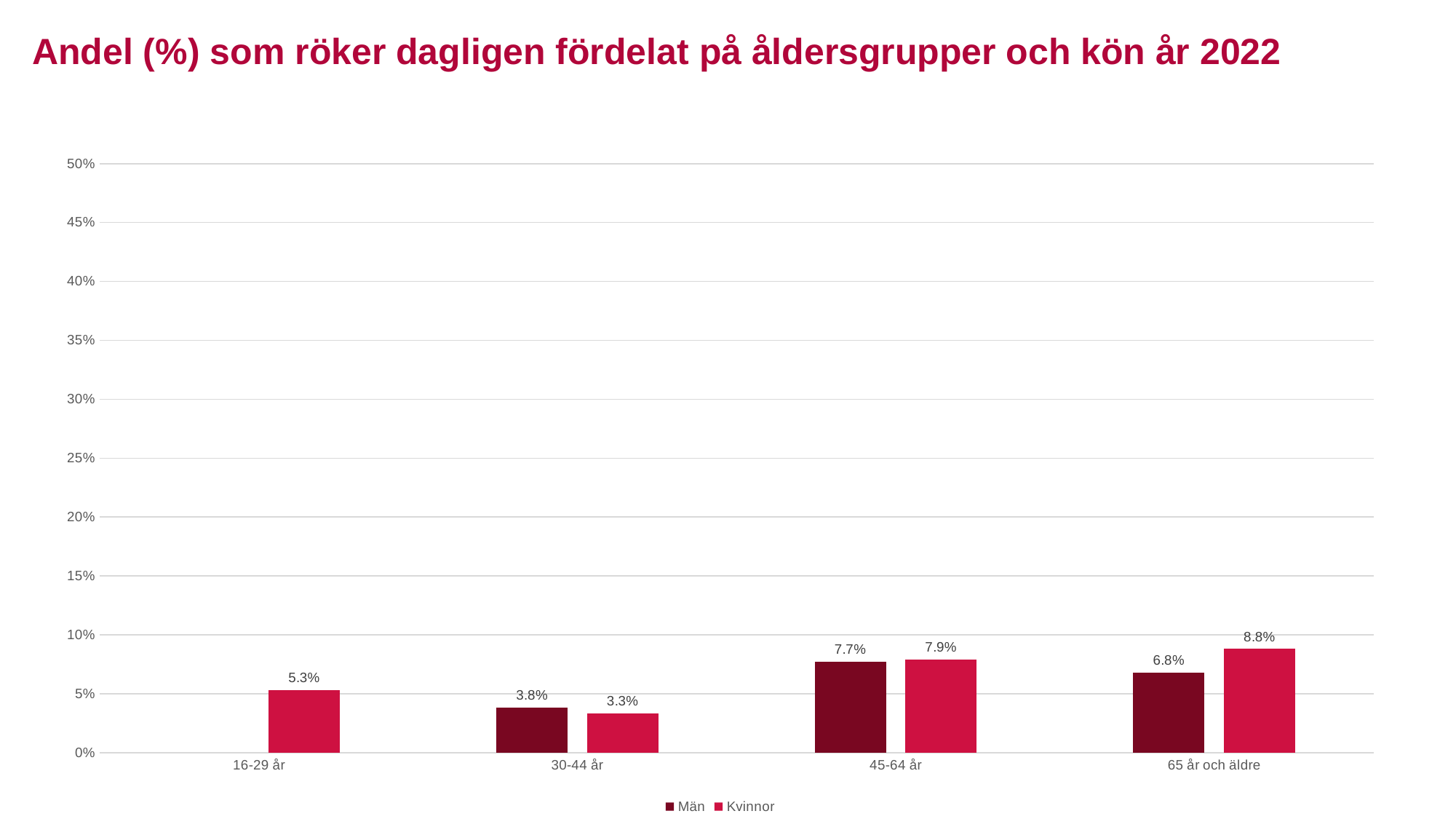
What is the value for Kvinnor in the 16-29 år age group? 5.3% What is the value for Män in the 65 år och äldre age group? 6.8% Which age group has the highest value for Kvinnor? 65 år och äldre Which is larger in the 30-44 år age group, the value for Män or for Kvinnor? Män What is the value for Kvinnor in the 45-64 år age group? 7.9% How many series does the legend list? 2 What is the value for Män in the 30-44 år age group? 3.8% Is the value for Kvinnor in the 65 år och äldre age group greater or less than 10%? less What is the difference between the Kvinnor and Män values in the 65 år och äldre age group? 2.0% What kind of chart is shown on the slide? bar chart Which age group has the lowest value for Kvinnor? 30-44 år How many age groups are shown on the x axis? 4